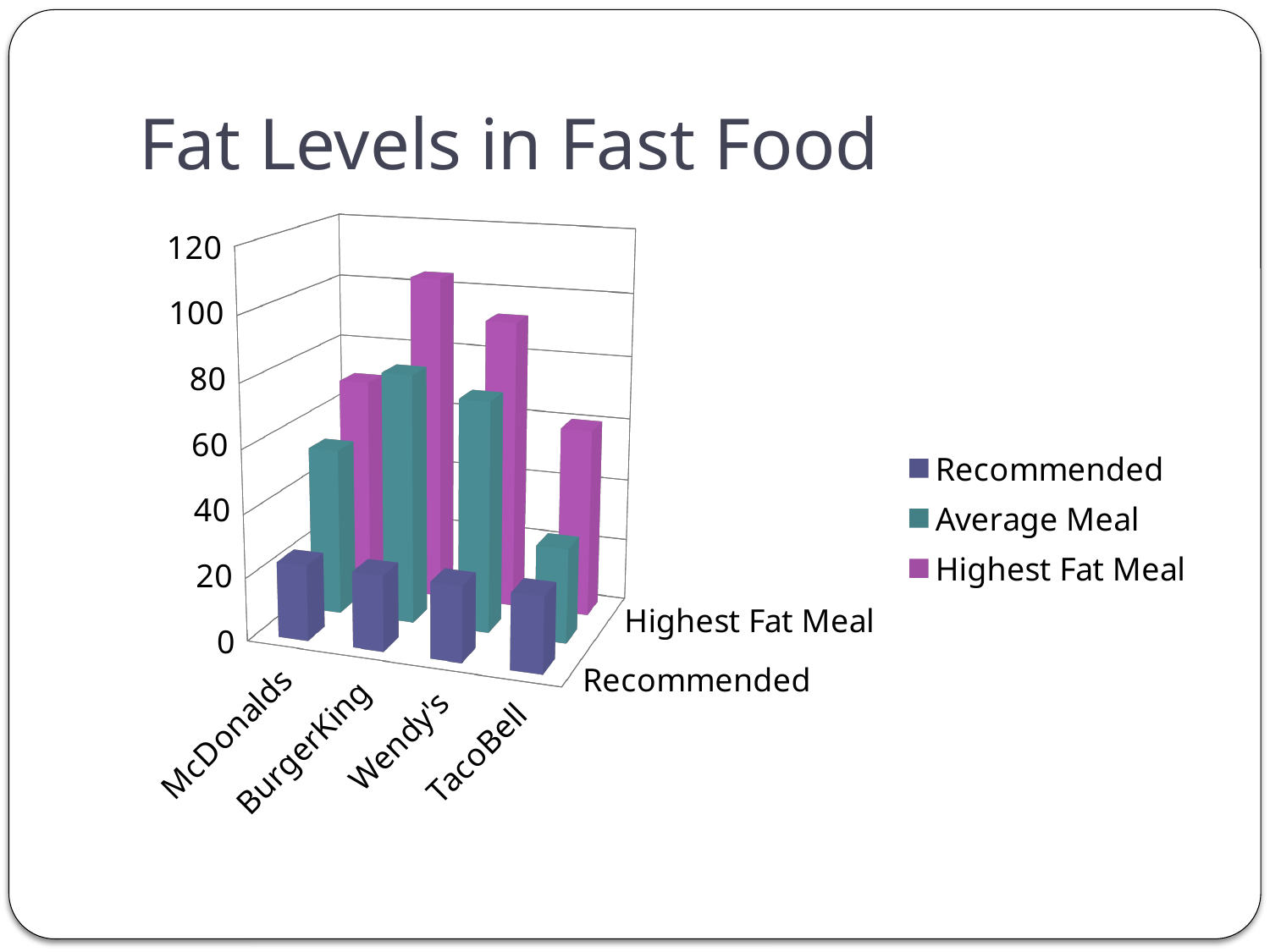
How many restaurant categories are shown on the x axis? 4 Which restaurant has the lowest Highest Fat Meal value? TacoBell Is the Average Meal value for TacoBell greater or less than 40? less Is the Highest Fat Meal value for TacoBell greater or less than 80? less How many series does the legend list? 3 Which series is shown in purple/magenta in the legend? Highest Fat Meal Which restaurant has the highest Highest Fat Meal value? BurgerKing Which restaurant has the lowest Average Meal value? TacoBell What is the title of the chart? Fat Levels in Fast Food Is the Highest Fat Meal value for Wendy's greater or less than 80? greater What kind of chart is shown on the slide? bar chart Which is larger, the Average Meal value for McDonalds or for TacoBell? McDonalds